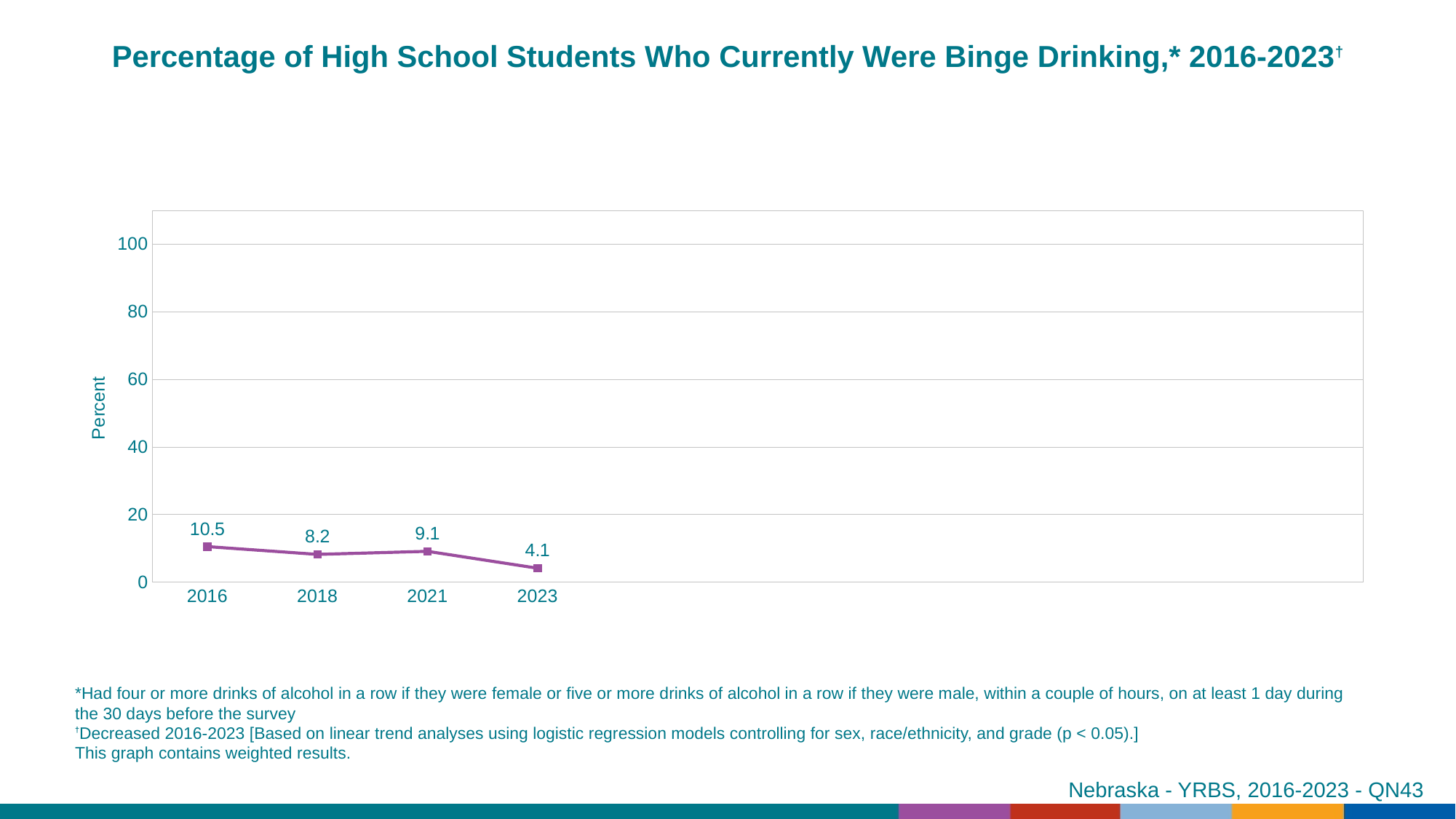
Is the value for 2016 greater or less than 20? less Which year has the highest percentage of students who currently were binge drinking? 2016 What kind of chart is shown on the slide? line chart What is the difference between the 2016 value and the 2023 value? 6.4 What is the value plotted for 2018? 8.2 Which year has a higher value, 2018 or 2021? 2021 Overall, do the values rise or fall from 2016 to 2023? fall What is the value plotted for 2023? 4.1 What is the label on the vertical axis of the chart? Percent How many years are plotted on the chart? 4 Which year has the lowest percentage of students who currently were binge drinking? 2023 What percentage of high school students currently were binge drinking in 2016? 10.5